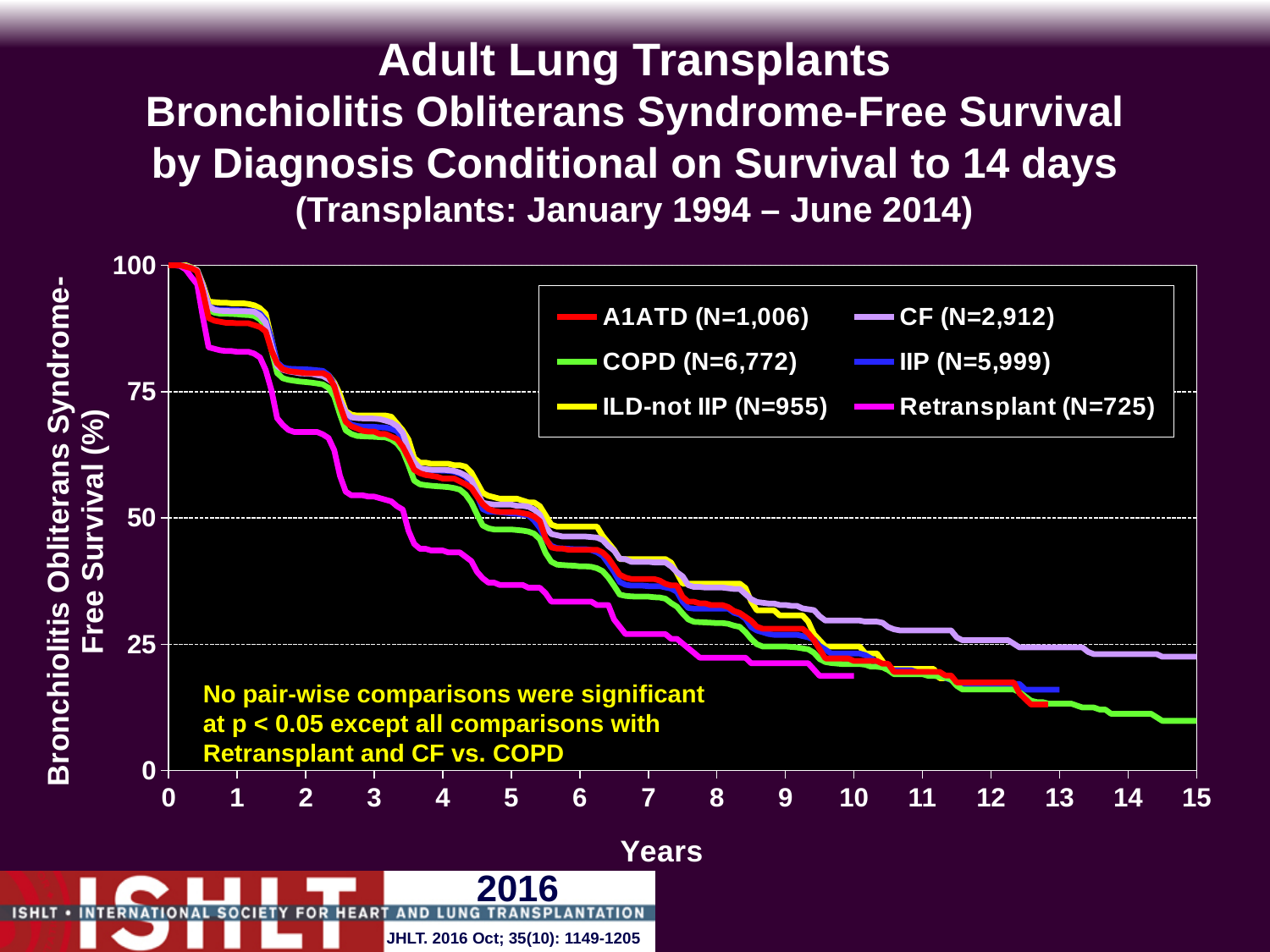
Is the value for Retransplant at 5 years greater or less than 50? less What kind of chart is shown on the slide? line chart How many series does the legend list? 6 What is the N shown in the legend for COPD? N=6,772 Do the survival curves rise or fall as the years increase along the x axis? fall Which series has the highest BOS-free survival at 14 years? CF Is the value for ILD-not IIP at 2 years greater or less than 75? greater What is the label of the x axis? Years Is the value for COPD at 15 years greater or less than 25? less Which series has the lowest BOS-free survival at 5 years? Retransplant At 10 years, which series has the higher BOS-free survival, CF or Retransplant? CF